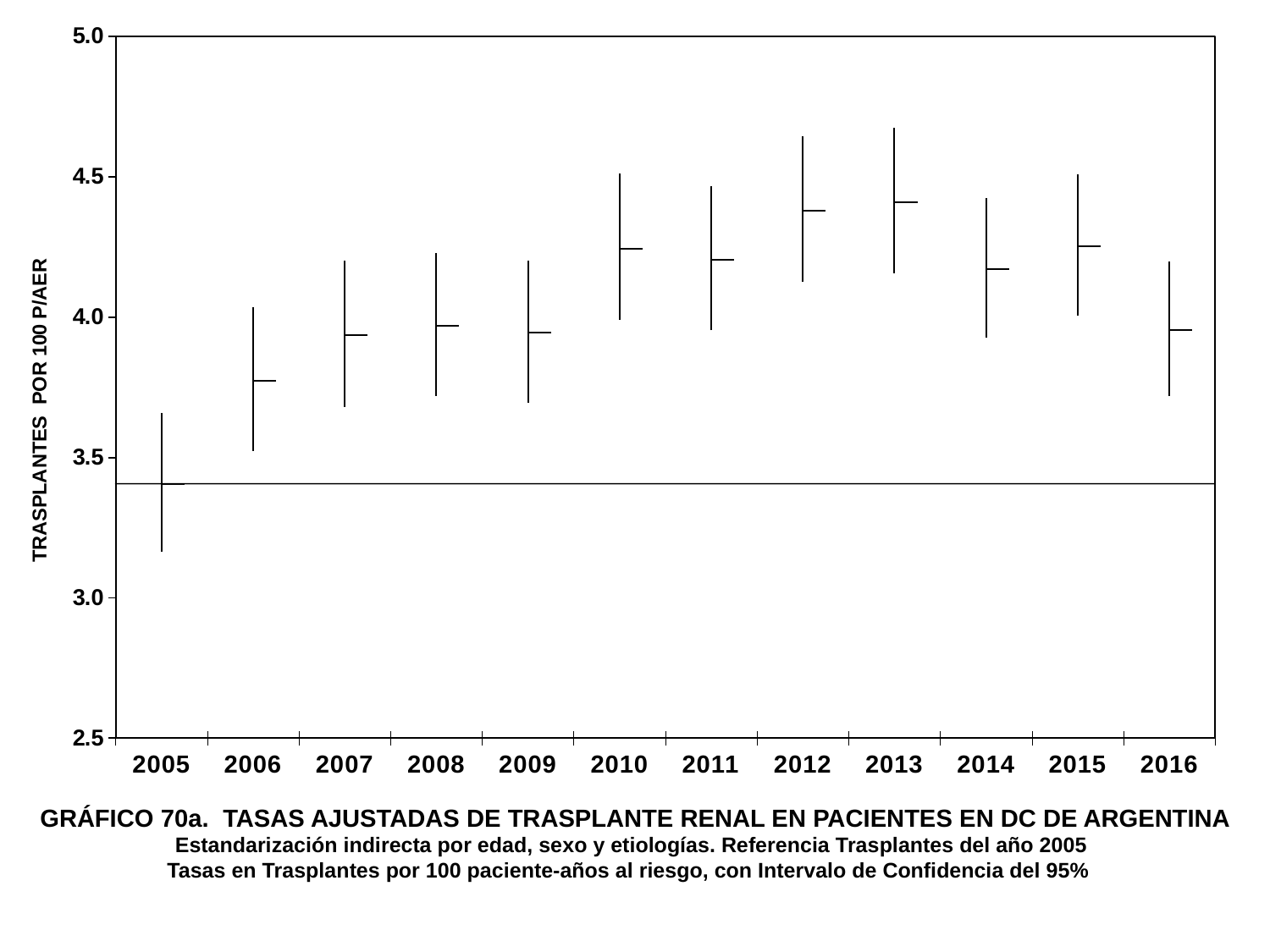
Do the values rise or fall from 2005 to 2010? rise Is the value for 2006 greater or less than 4.0? less Is the value for 2005 greater or less than 3.5? less Which is larger, the value for 2013 or the value for 2016? 2013 Which is larger, the value for 2006 or the value for 2012? 2012 Is the value for 2014 greater or less than 4.5? less Which year has the lowest adjusted transplant rate? 2005 What is the label of the y axis? TRASPLANTES POR 100 P/AER How many years are plotted on the x axis? 12 Which is larger, the value for 2005 or the value for 2010? 2010